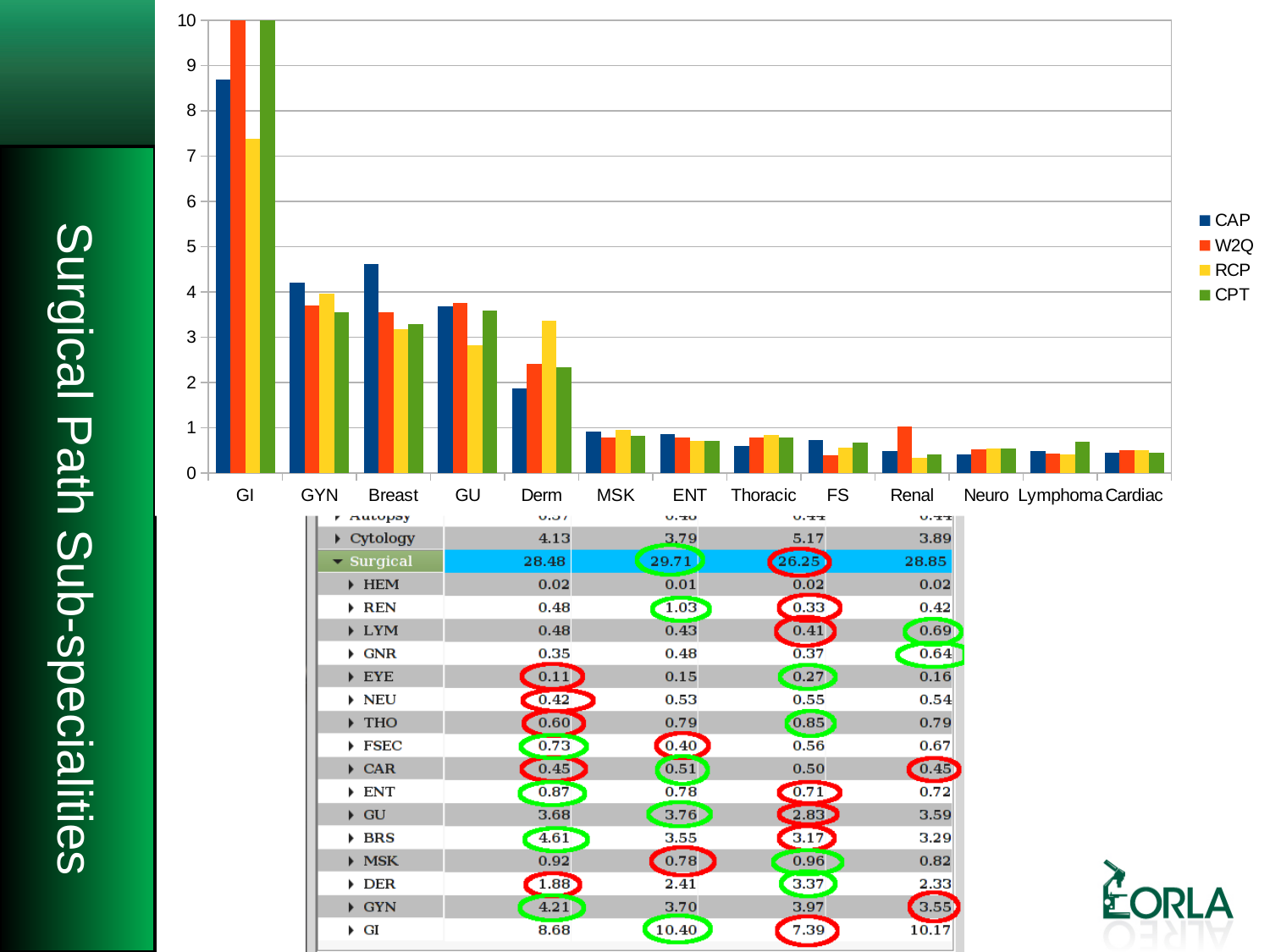
Is the RCP value for Derm greater or less than 3? greater For Renal, which series has the larger value, W2Q or RCP? W2Q Is the RCP value for GI greater or less than 8? less Is the CAP value for Breast greater or less than 4? greater For Derm, which series has the larger value, CAP or RCP? RCP How many series does the chart's legend list? 4 Which category has the highest CAP value in the chart? GI For GI, which of the four series has the lowest value? RCP How many categories are shown along the x axis of the chart? 13 What kind of chart is shown on the slide? bar chart Which series is shown in yellow in the chart's legend? RCP